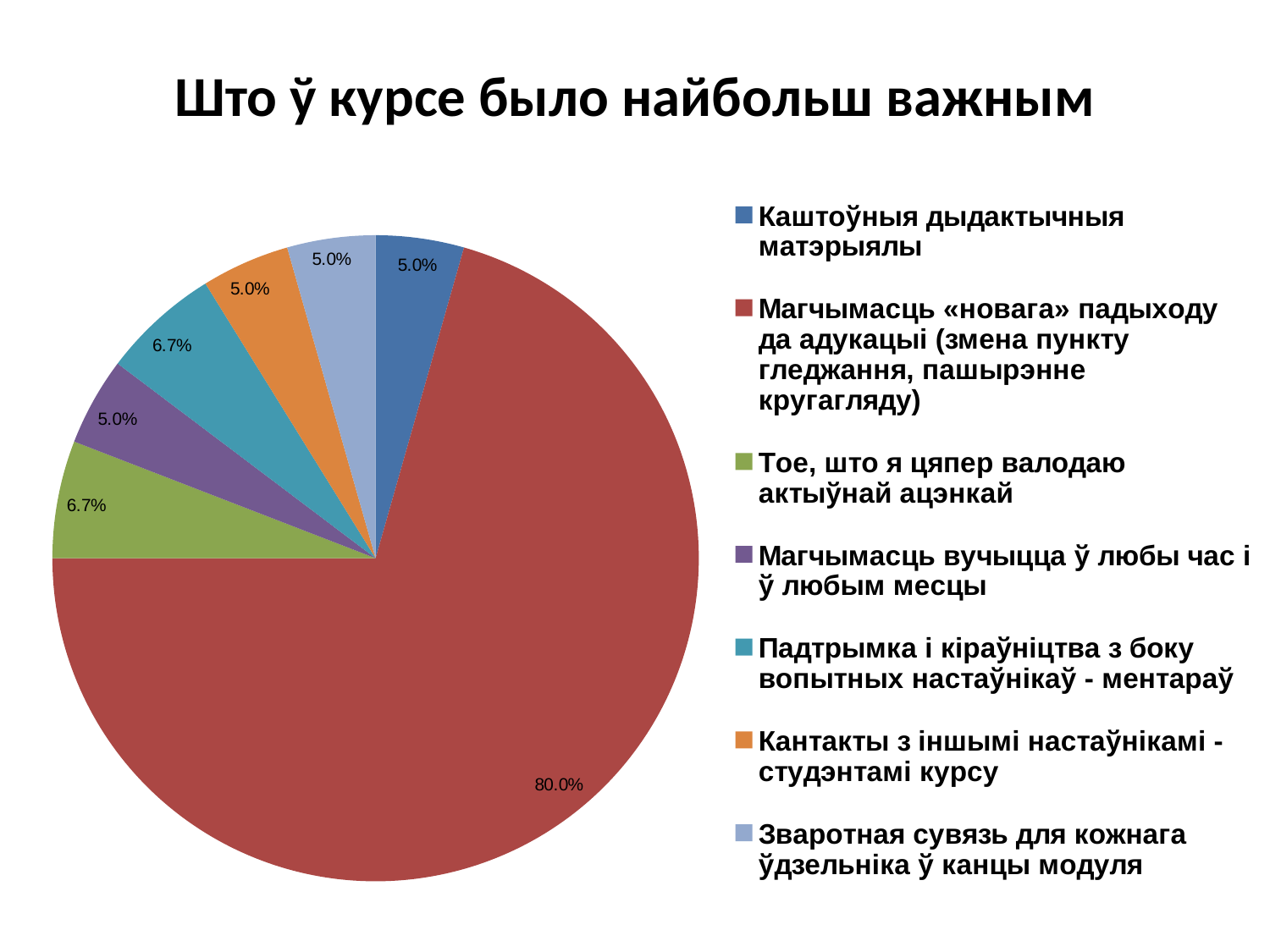
What percentage is shown for «Падтрымка і кіраўніцтва з боку вопытных настаўнікаў - ментараў»? 6.7% Which category has the largest slice of the pie? Магчымасць «новага» падыходу да адукацыі (змена пункту гледжання, пашырэнне кругагляду) Which is larger: the slice for «Тое, што я цяпер валодаю актыўнай ацэнкай» or the slice for «Кантакты з іншымі настаўнікамі - студэнтамі курсу»? Тое, што я цяпер валодаю актыўнай ацэнкай How many slices does the pie chart have? 7 What percentage is shown for «Зваротная сувязь для кожнага ўдзельніка ў канцы модуля»? 5.0% What is the title of the chart? Што ў курсе было найбольш важным How many entries does the legend list? 7 What percentage is shown for «Тое, што я цяпер валодаю актыўнай ацэнкай»? 6.7% What percentage is shown for «Каштоўныя дыдактычныя матэрыялы»? 5.0% What percentage is shown for «Магчымасць «новага» падыходу да адукацыі»? 80.0% What kind of chart is shown on the slide? Pie chart What is the difference between the percentage for «Магчымасць «новага» падыходу да адукацыі» and the percentage for «Магчымасць вучыцца ў любы час і ў любым месцы»? 75.0%